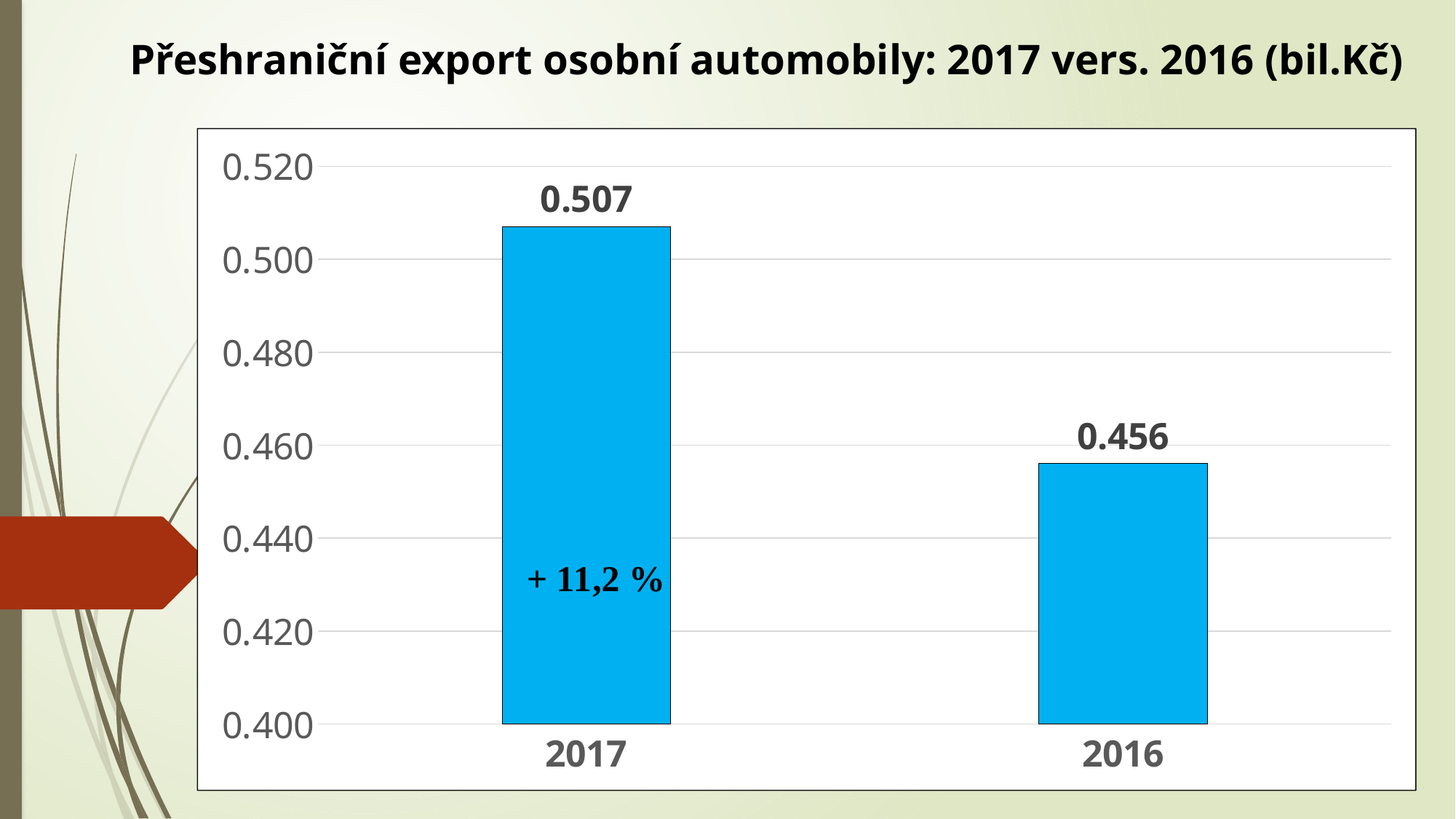
Is the value for 2017 larger or smaller than the value for 2016? larger Which year has the lower value? 2016 How many bars are shown in the chart? 2 What percentage change is printed on the 2017 bar? + 11,2 % What is the value for 2017? 0.507 What is the difference between the 2017 and 2016 values? 0.051 Which year has the higher value? 2017 What unit is given in the chart title? bil.Kč Is the value for 2017 greater or less than 0.500? greater What kind of chart is shown on the slide? bar chart Is the value for 2016 greater or less than 0.480? less What is the value for 2016? 0.456